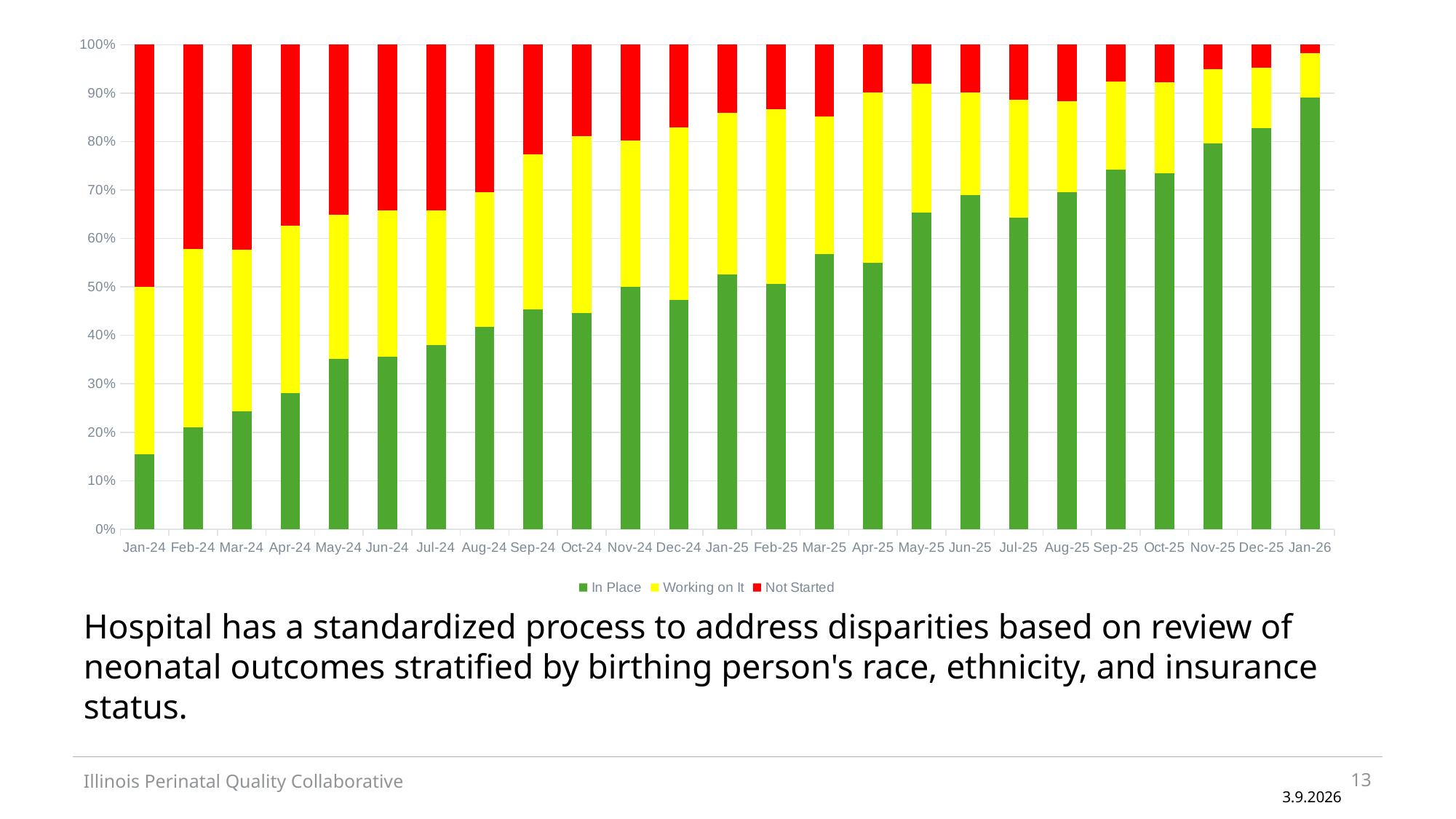
Which colour represents the Not Started series in the legend? Red Is the In Place share for Jan-26 greater or less than 80%? greater Which is larger, the In Place share in Jan-26 or in Jan-24? Jan-26 What kind of chart is shown on the slide? Stacked bar chart How many months (categories) are plotted along the x axis? 25 Is the In Place share for Jan-24 greater or less than 20%? less Is the In Place share for Sep-25 greater or less than 70%? greater Which month has the largest Not Started share? Jan-24 Which month has the highest In Place share? Jan-26 How many series does the legend list? 3 Which month has the lowest In Place share? Jan-24 Does the In Place share rise or fall from Jan-24 to Jan-26? Rise